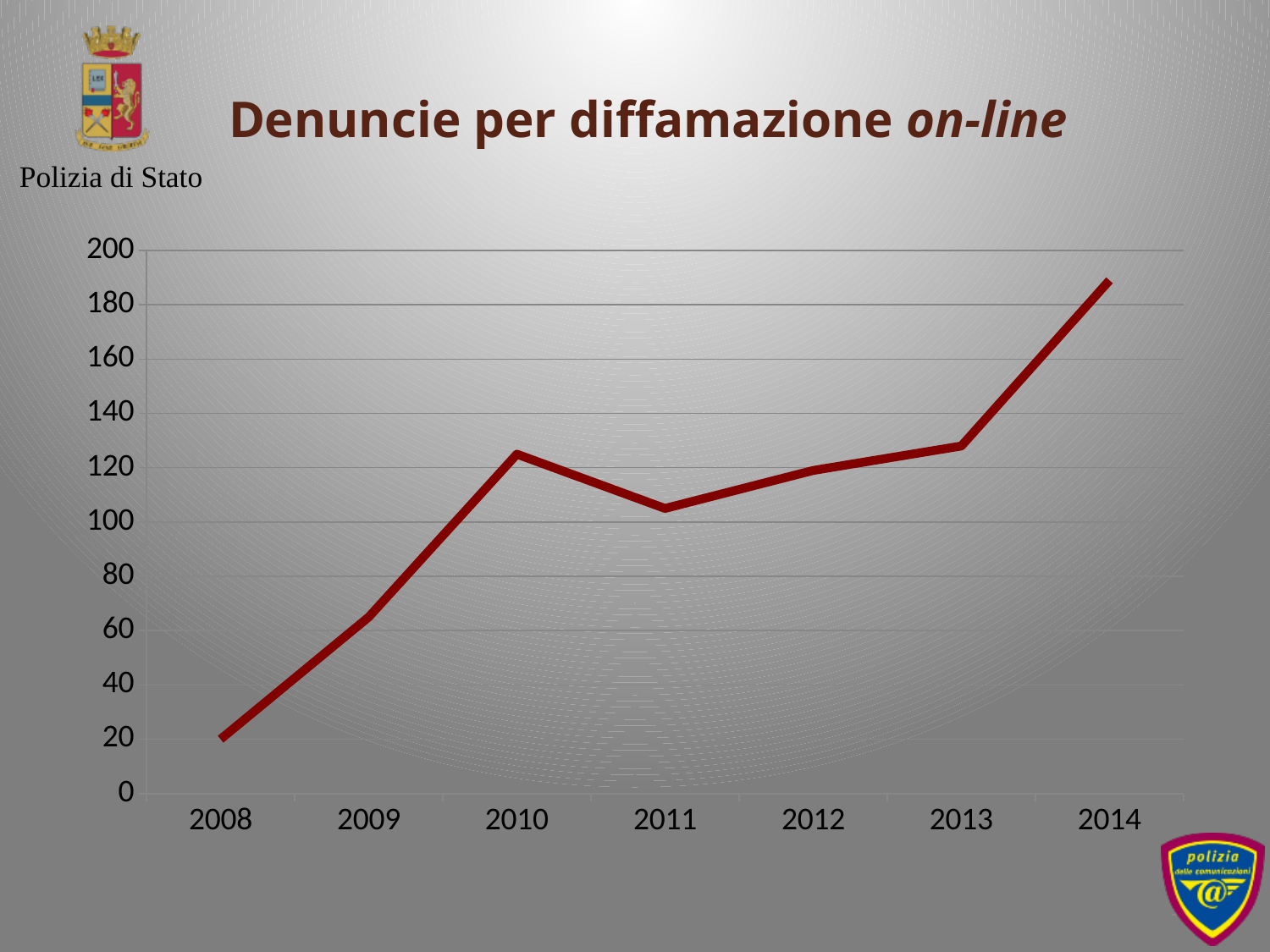
Is the value for 2014 greater or less than 180? greater Which is larger, the value for 2010 or the value for 2011? 2010 What is the title of the chart? Denuncie per diffamazione on-line Is the value for 2008 greater or less than 40? less Which year has the lowest value? 2008 Which year has the highest value? 2014 Does the line rise or fall between 2013 and 2014? rise Is the value for 2010 greater or less than 120? greater What kind of chart is shown on the slide? line chart How many years are plotted along the x axis? 7